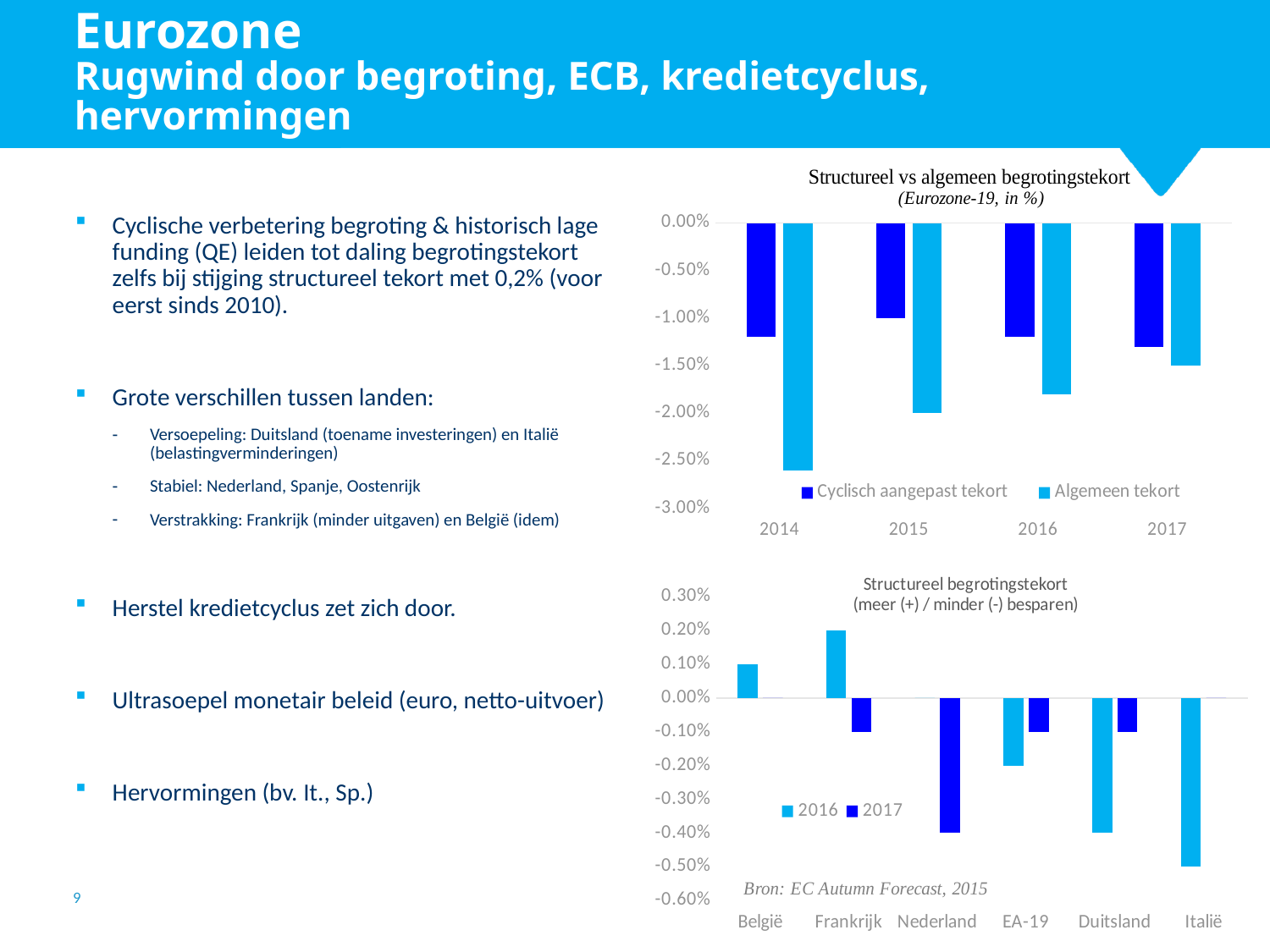
What are the two legend entries of the top chart 'Structureel vs algemeen begrotingstekort'? Cyclisch aangepast tekort; Algemeen tekort In the top chart 'Structureel vs algemeen begrotingstekort', do the Algemeen tekort bars get shorter or longer from 2014 to 2017? shorter How many series does the legend of the top chart 'Structureel vs algemeen begrotingstekort' list? 2 In the top chart 'Structureel vs algemeen begrotingstekort', is the Algemeen tekort value for 2014 greater or less than -2.00%? less In the top chart 'Structureel vs algemeen begrotingstekort', is the Cyclisch aangepast tekort value for 2015 greater or less than -1.50%? greater How many countries/regions are shown on the x axis of the bottom chart 'Structureel begrotingstekort'? 6 What kind of chart is the top chart titled 'Structureel vs algemeen begrotingstekort'? Bar chart In the bottom chart 'Structureel begrotingstekort', is the 2016 value for Italië greater or less than -0.40%? less In the bottom chart 'Structureel begrotingstekort', which category has the lowest 2016 value? Italië In the bottom chart 'Structureel begrotingstekort', which category has the highest 2016 value? Frankrijk In the top chart 'Structureel vs algemeen begrotingstekort', which series has the bar extending further below zero in 2014? Algemeen tekort How many years are shown on the x axis of the top chart 'Structureel vs algemeen begrotingstekort'? 4